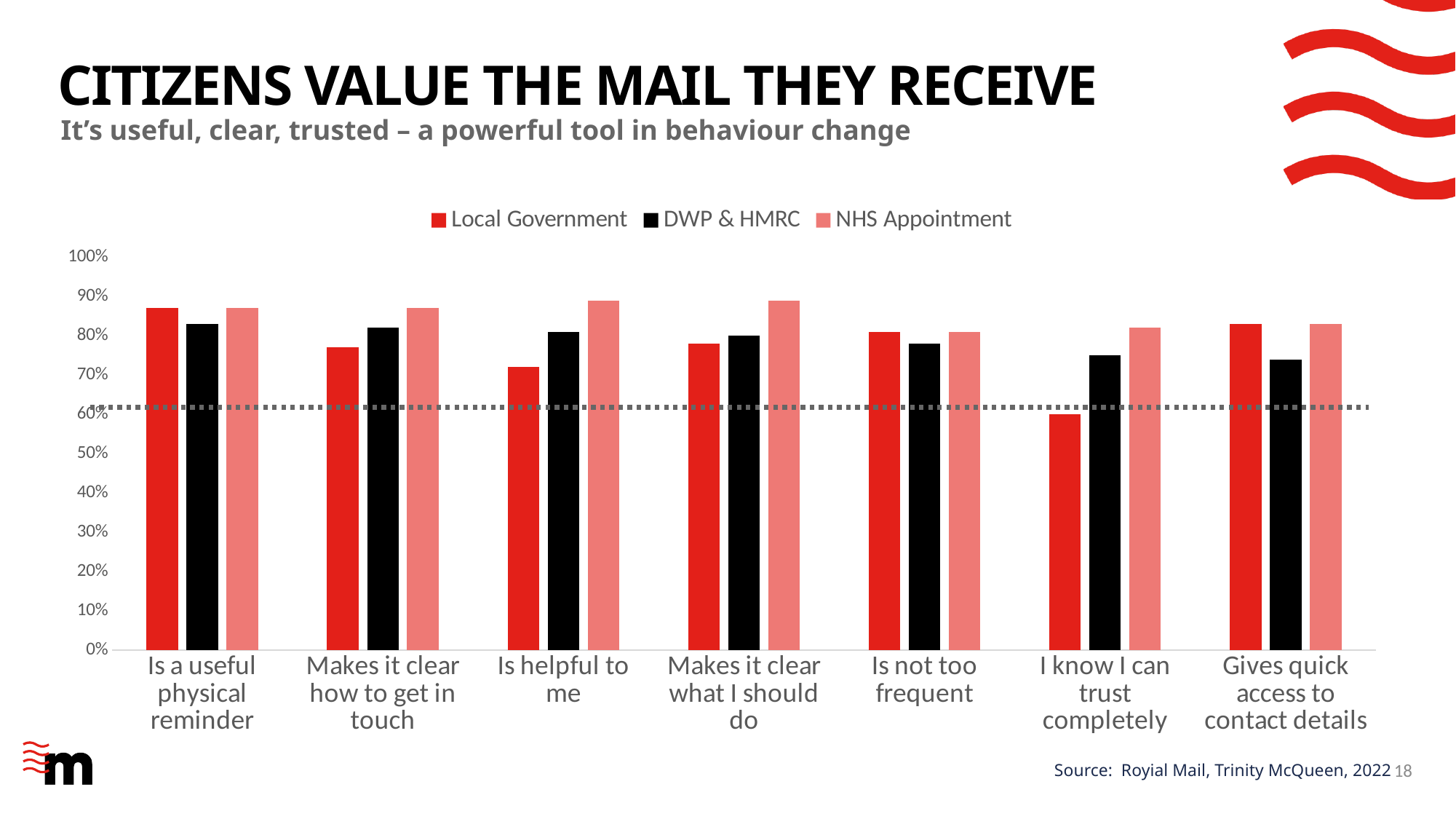
Is the NHS Appointment value for 'Is helpful to me' greater or less than 80%? greater How many series does the legend list? 3 How many categories are shown along the x axis? 7 For 'I know I can trust completely', which is larger: the NHS Appointment value or the Local Government value? NHS Appointment For 'Is helpful to me', which is larger: the DWP & HMRC value or the Local Government value? DWP & HMRC Is the Local Government value for 'I know I can trust completely' greater or less than 70%? less Is the Local Government value for 'Is helpful to me' greater or less than 80%? less What kind of chart is shown on the slide? Bar chart For 'Makes it clear how to get in touch', which is larger: the NHS Appointment value or the Local Government value? NHS Appointment What colour represents the DWP & HMRC series in the legend? Black Which category has the lowest Local Government value? I know I can trust completely